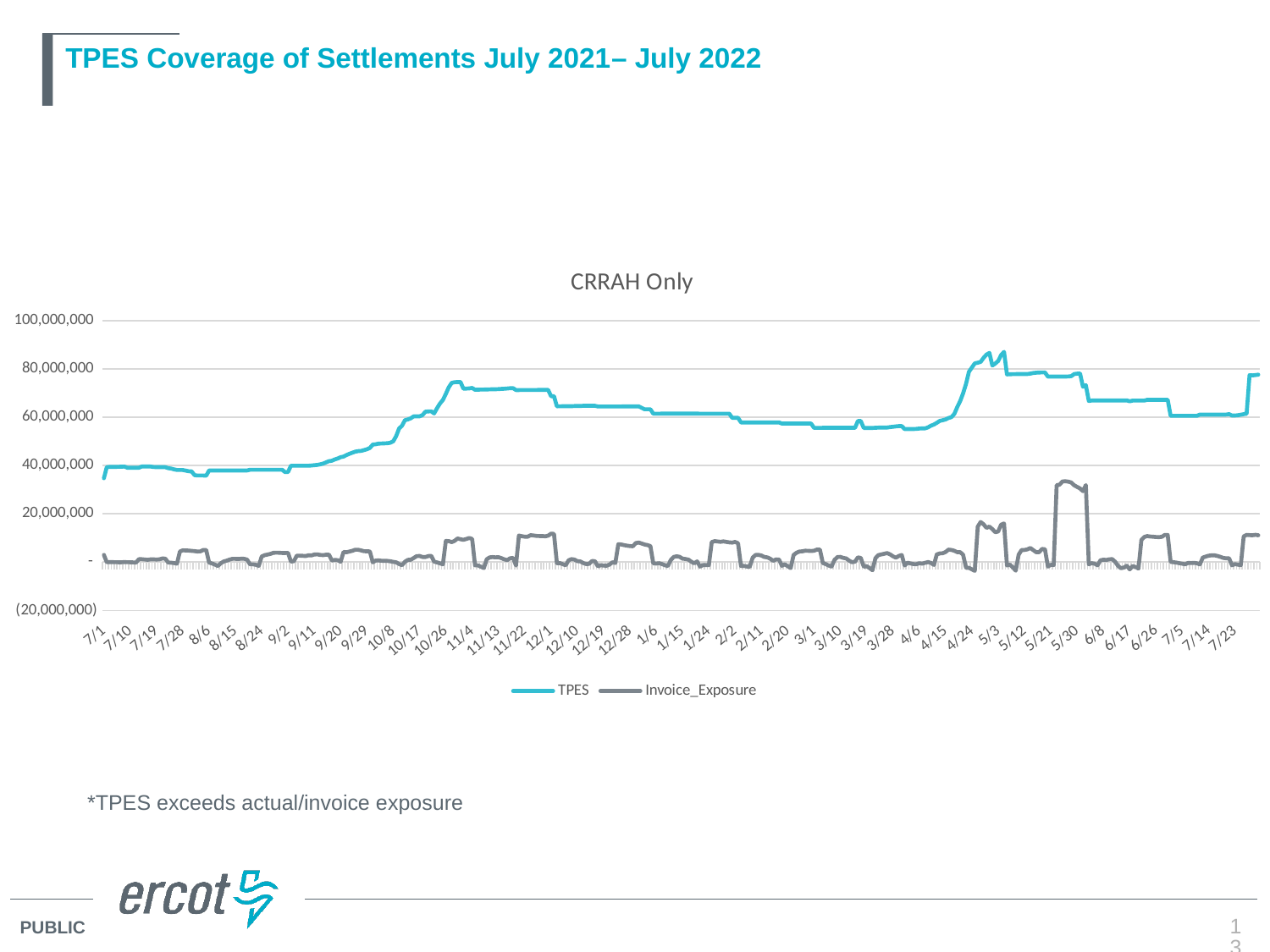
Which series reaches the highest value in the CRRAH Only chart? TPES What kind of chart is shown on the slide? line chart Is the Invoice_Exposure value around 5/30 greater or less than 20,000,000? greater Is the TPES value at 11/4 greater or less than 60,000,000? greater Is the TPES value around 5/3 greater or less than 80,000,000? greater Which series is drawn in cyan in the CRRAH Only chart? TPES What is the title of the chart on the slide? CRRAH Only At 5/3, which series has the larger value, TPES or Invoice_Exposure? TPES How many series does the legend of the CRRAH Only chart list? 2